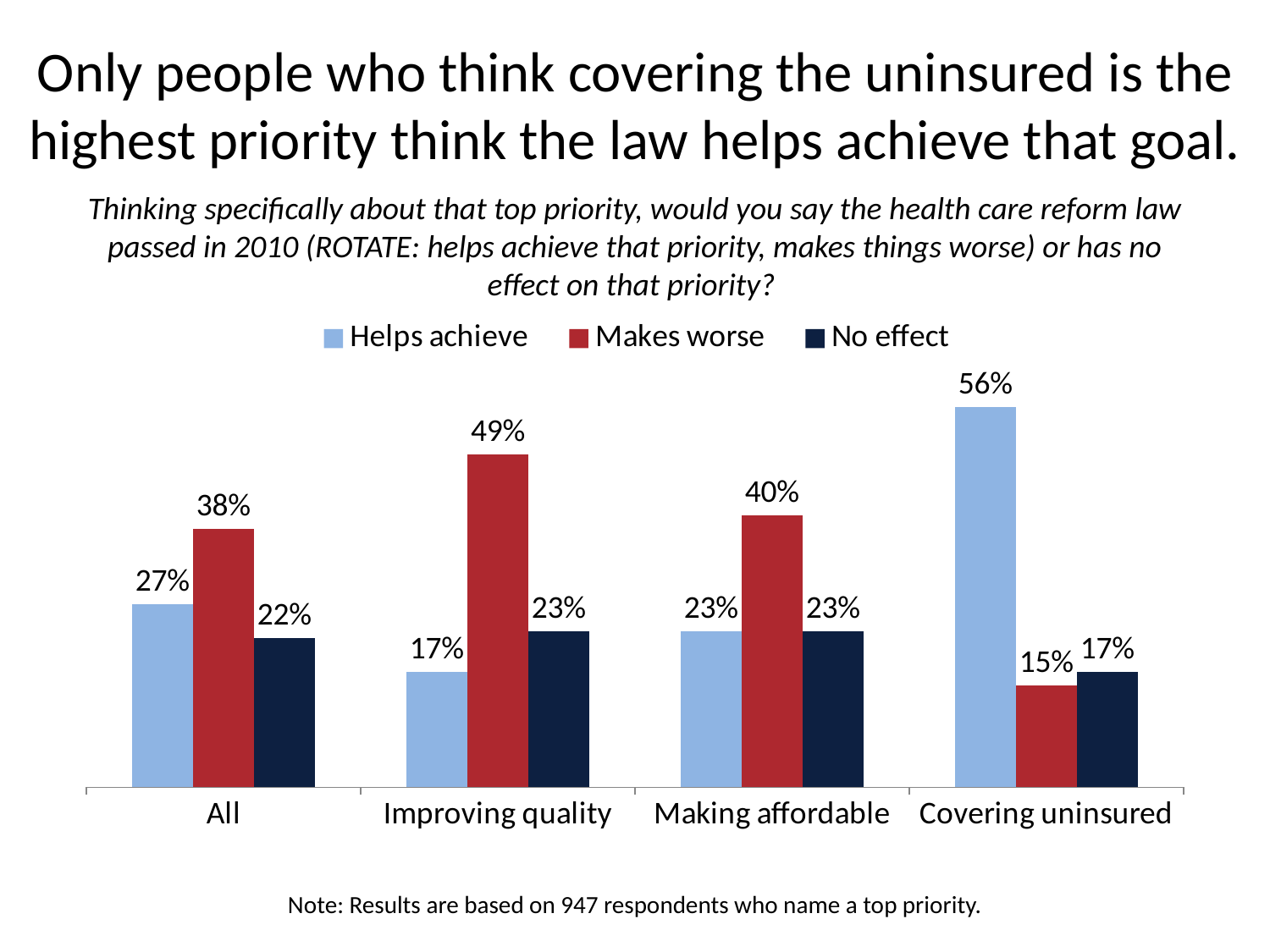
What is the value for "Makes worse" in the "Improving quality" category? 49% What is the value for "Helps achieve" in the "Covering uninsured" category? 56% Which is larger in the "Making affordable" category: "Helps achieve" or "Makes worse"? Makes worse What is the difference between "Makes worse" for "Improving quality" and "Makes worse" for "All"? 11% Which category has the highest "Helps achieve" value? Covering uninsured Which colour represents the "Makes worse" series? Red What kind of chart is shown on the slide? Bar chart How many categories are shown on the x axis? 4 How many series does the legend list? 3 What is the difference between "Helps achieve" and "Makes worse" in the "Covering uninsured" category? 41% What is the value for "No effect" in the "All" category? 22% Which category has the lowest "Makes worse" value? Covering uninsured